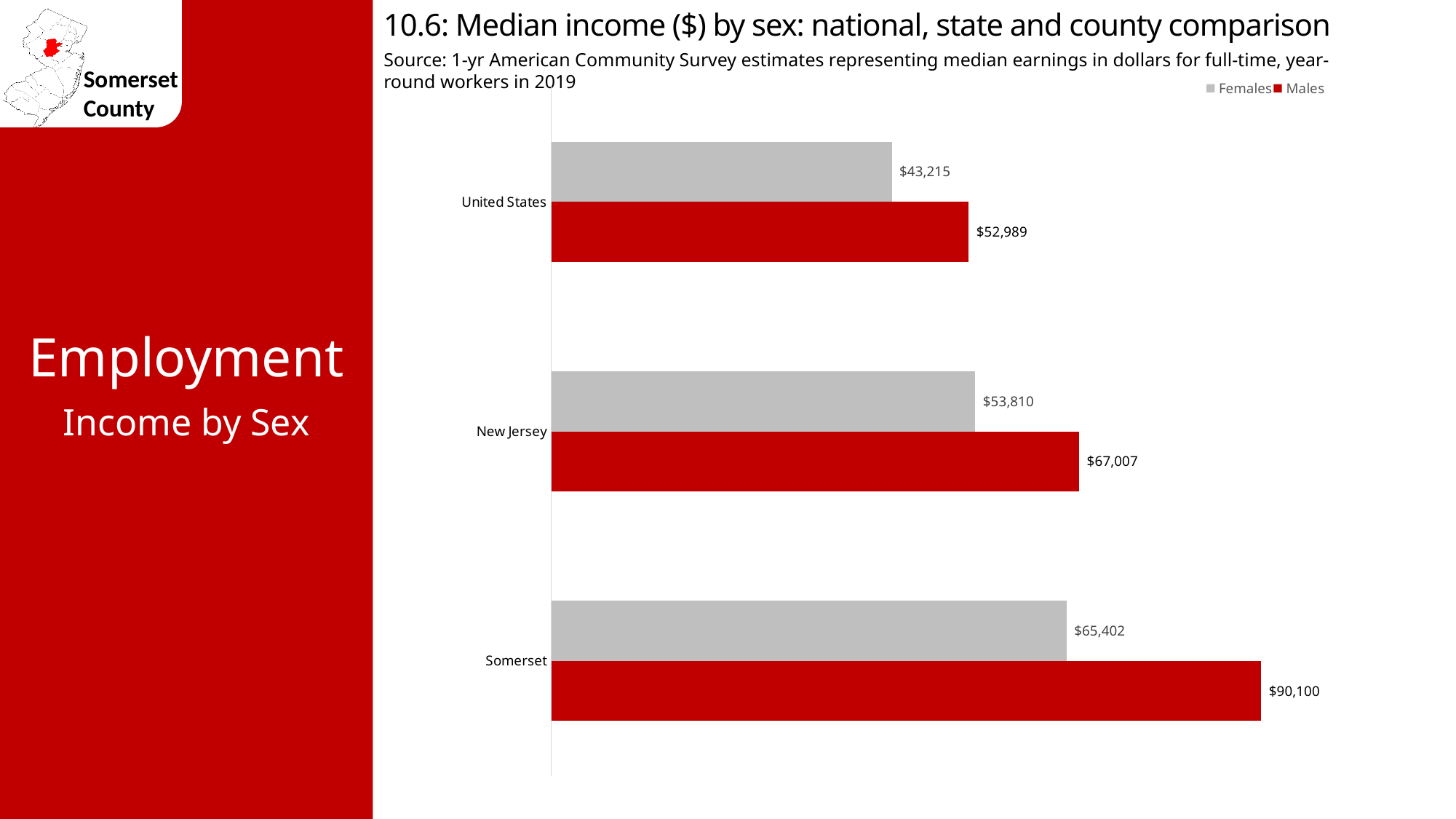
What is the median income for Males in Somerset? $90,100 What is the median income for Females in Somerset? $65,402 What is the difference between the Males and Females median income in Somerset? $24,698 Which is larger: the Females median income in Somerset or the Males median income in the United States? Females median income in Somerset Which geography has the lowest median income for Females? United States What is the median income for Males in New Jersey? $67,007 What is the median income for Females in the United States? $43,215 Which geography has the highest median income for Males? Somerset How many series does the legend list? 2 What kind of chart is shown on the slide? Bar chart What is the difference between the Males and Females median income in New Jersey? $13,197 How many geographies are shown on the chart? 3